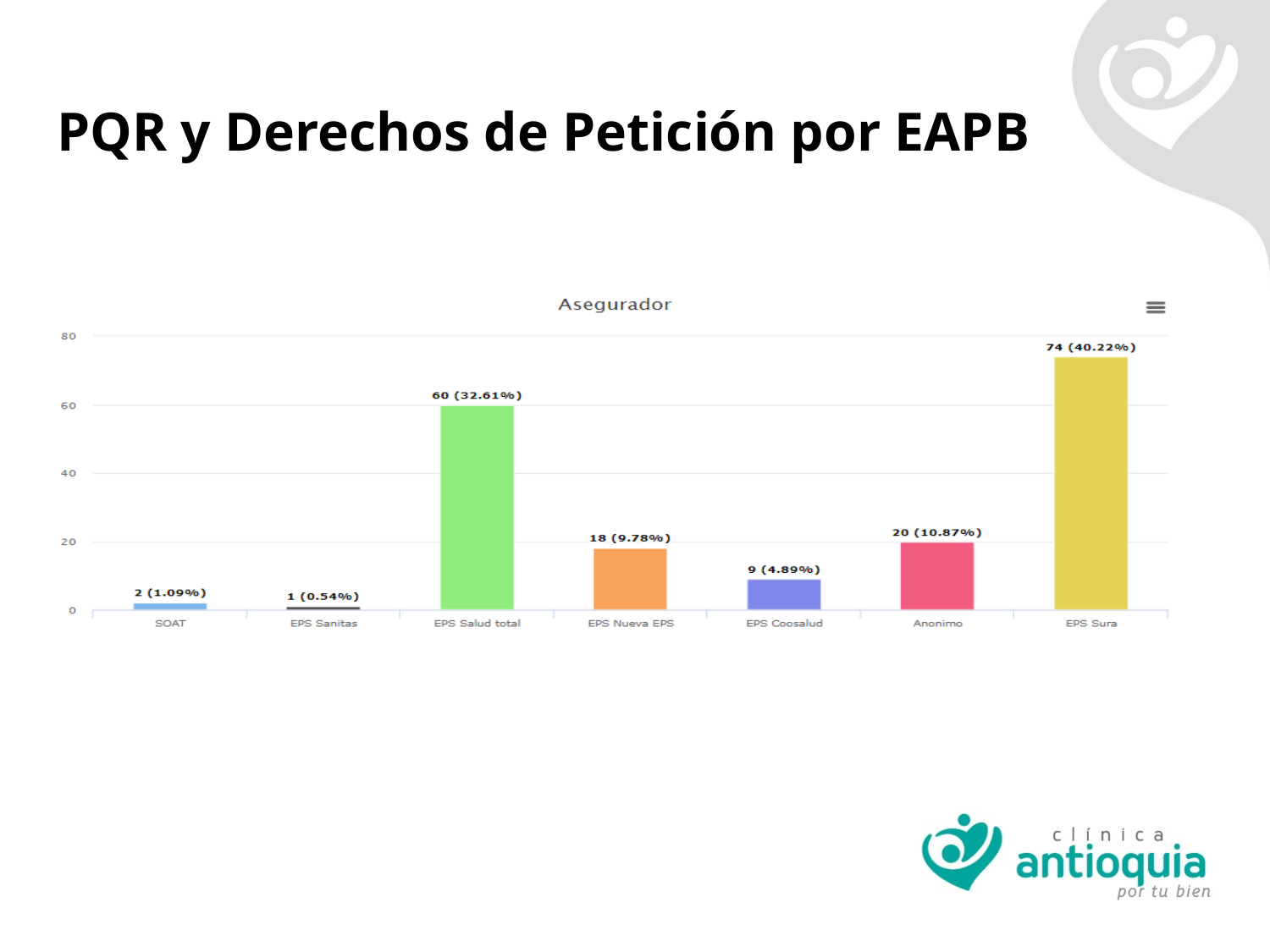
What is the title of the chart? Asegurador Which category has the highest value? EPS Sura What is the value for EPS Salud total? 60 (32.61%) What is the value for EPS Sura? 74 (40.22%) Is the value for EPS Salud total greater or less than 40? greater Which has a larger value, EPS Nueva EPS or Anonimo? Anonimo What is the value for EPS Coosalud? 9 (4.89%) Which category has the lowest value? EPS Sanitas What is the value for Anonimo? 20 (10.87%) What is the difference in count between EPS Sura and EPS Salud total? 14 What type of chart is shown on the slide? bar chart How many categories are shown on the x axis of the chart? 7